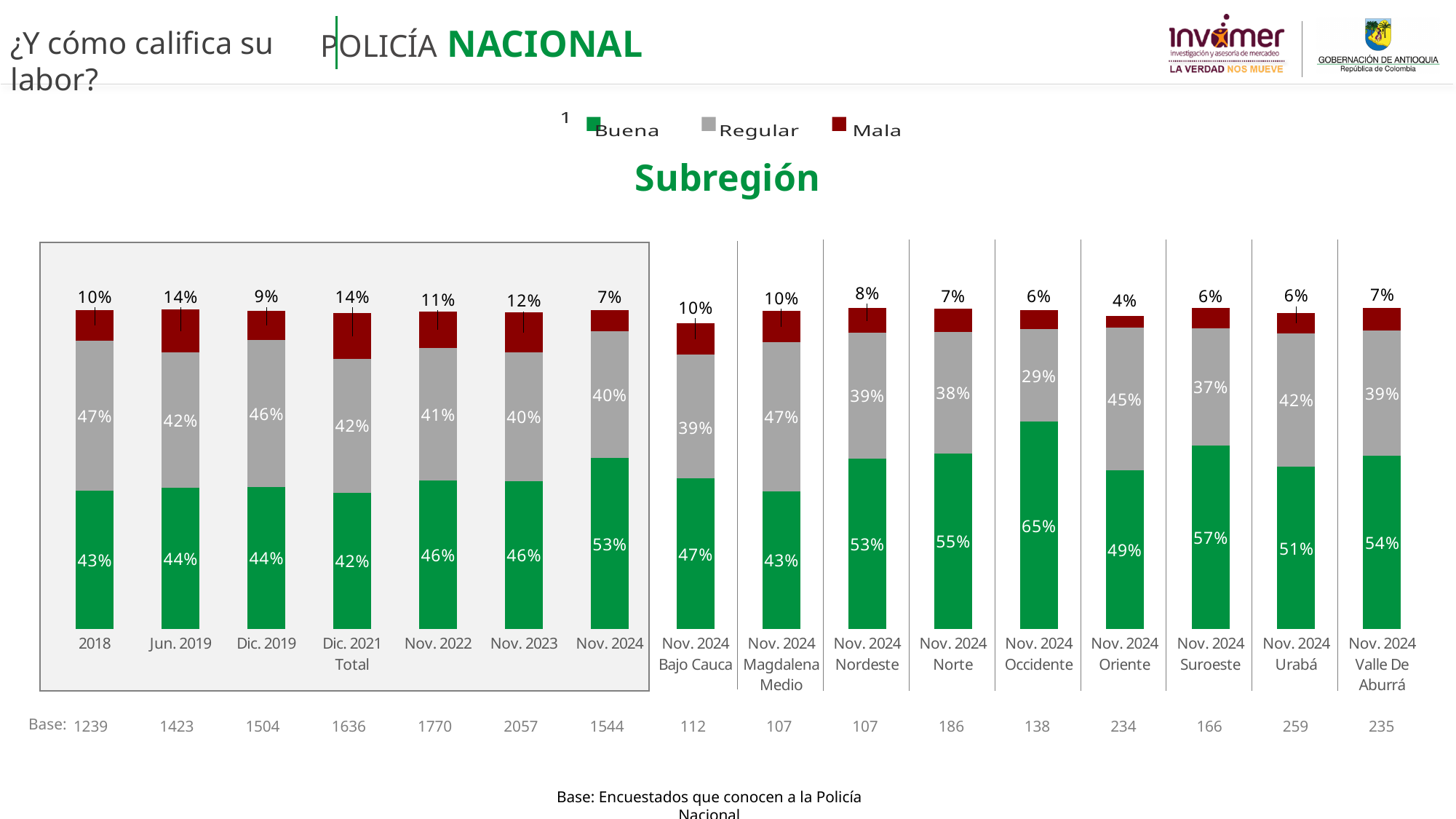
What is the total of the stacked bar for Nov. 2024 Norte? 100% How many bars are plotted in the chart? 16 What is the base (number of respondents) shown for Nov. 2024 Valle De Aburrá? 235 What is the "Mala" value for Dic. 2021? 14% What percentage of respondents rated the Policía Nacional's work as "Buena" in Nov. 2024 (Total)? 53% Which subregion has the lowest "Mala" percentage in Nov. 2024? Oriente How many series does the legend list? 3 What is the difference between the "Buena" value for Nov. 2024 Occidente and Nov. 2024 Magdalena Medio? 22% Which subregion has the highest "Buena" percentage in Nov. 2024? Occidente What kind of chart is shown on the slide? Stacked bar chart What is the "Regular" value for Nov. 2024 Occidente? 29% Which is larger, the "Buena" value for Nov. 2024 Suroeste or for Nov. 2024 Urabá? Nov. 2024 Suroeste